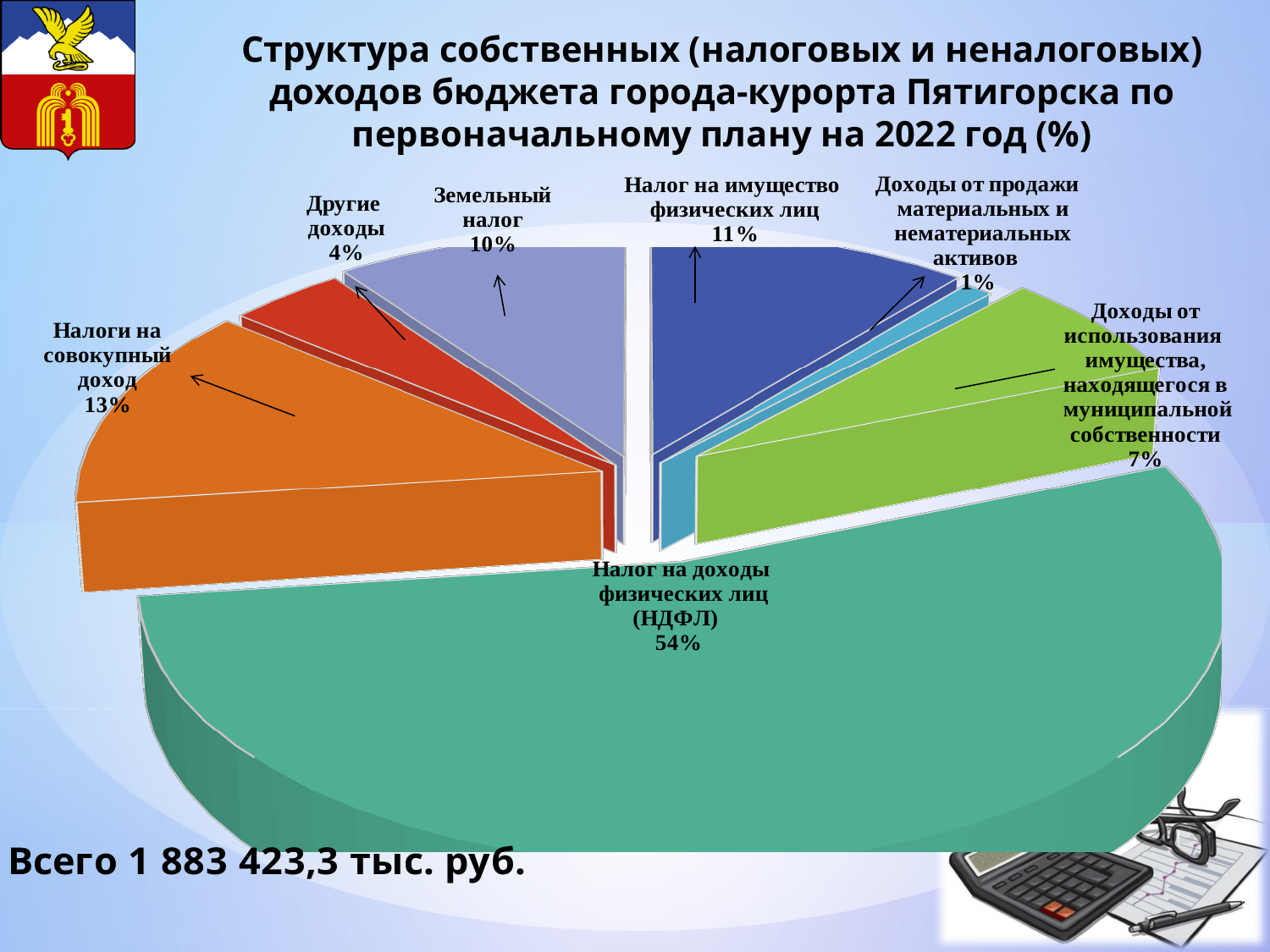
What percentage is shown for «Налог на имущество физических лиц»? 11% What percentage is shown for «Земельный налог»? 10% What percentage is shown for «Доходы от использования имущества, находящегося в муниципальной собственности»? 7% What is the difference in percentage points between «Налоги на совокупный доход» and «Другие доходы»? 9 Which is larger: the share of «Налог на имущество физических лиц» or the share of «Земельный налог»? Налог на имущество физических лиц How many categories (slices) does the pie chart have? 7 What percentage is shown for «Налоги на совокупный доход»? 13% What share of the budget's own revenues does «Налог на доходы физических лиц (НДФЛ)» account for? 54% Which category has the largest share of the pie? Налог на доходы физических лиц (НДФЛ) Which category has the smallest share of the pie? Доходы от продажи материальных и нематериальных активов What type of chart is shown on the slide? Pie chart What total amount of own revenues is stated on the slide? 1 883 423,3 тыс. руб.